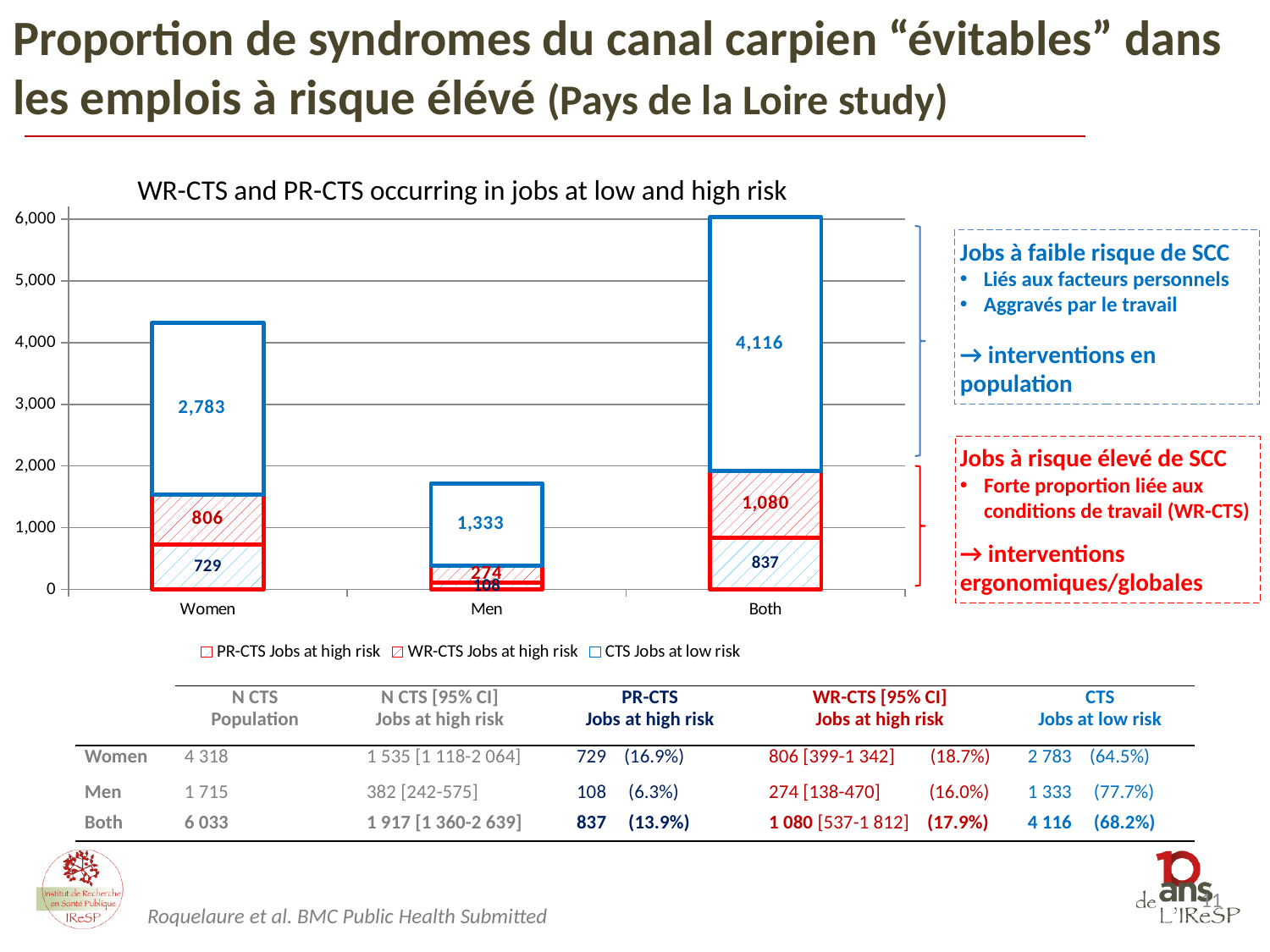
What is the difference between the WR-CTS Jobs at high risk values for Women and Men? 532 What is the value of CTS Jobs at low risk for Women? 2,783 What is the value of WR-CTS Jobs at high risk for Men? 274 What is the title of the chart? WR-CTS and PR-CTS occurring in jobs at low and high risk What is the value of PR-CTS Jobs at high risk for Both? 837 Which is larger for Women: PR-CTS Jobs at high risk or WR-CTS Jobs at high risk? WR-CTS Jobs at high risk Which category has the highest value for CTS Jobs at low risk? Both Which category has the lowest value for PR-CTS Jobs at high risk? Men How many categories are shown on the x axis of the chart? 3 What is the total of the stacked bar for Both? 6,033 What type of chart is shown on the slide? stacked bar chart How many series does the chart legend list? 3